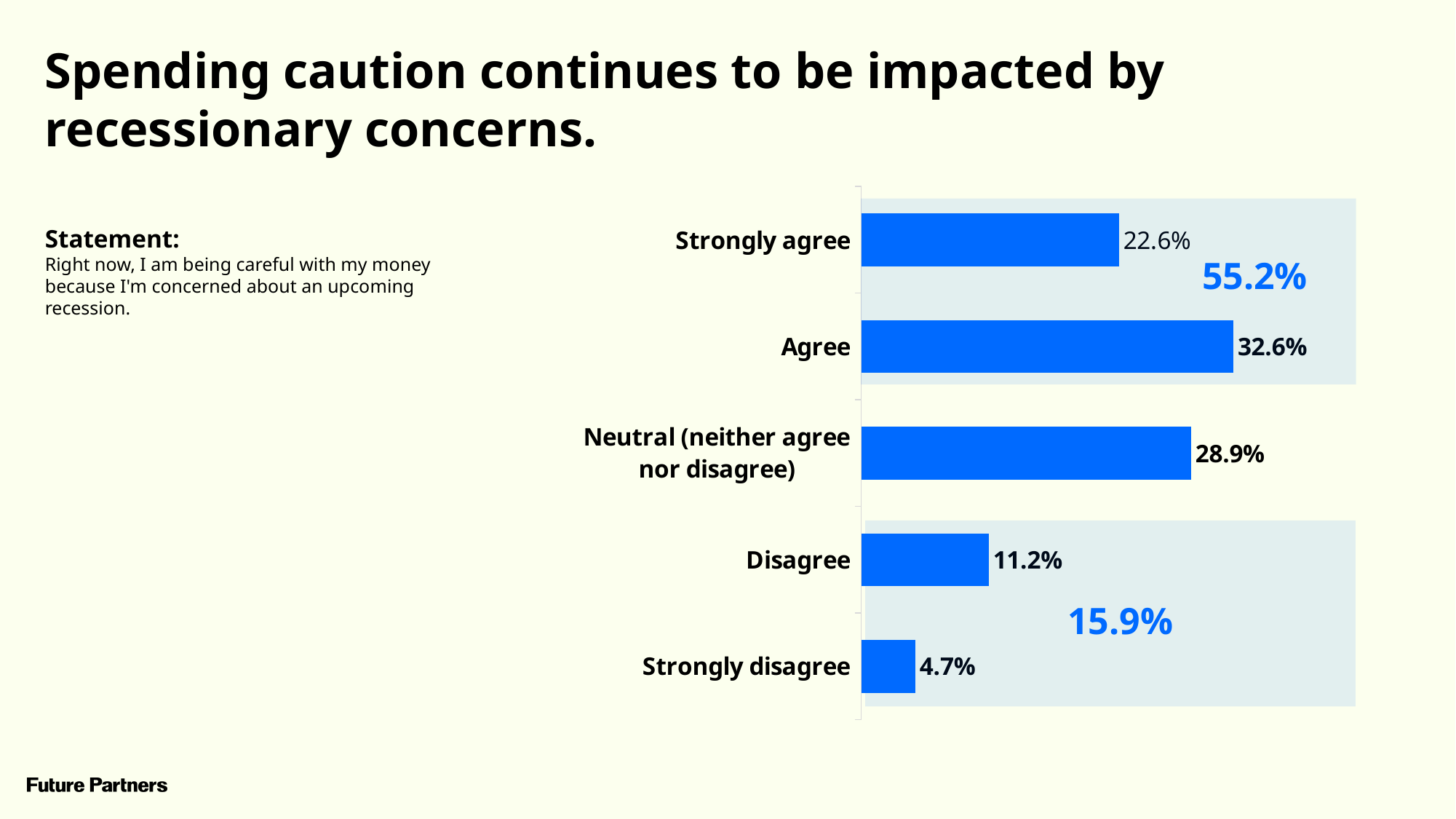
What combined percentage is shown for Strongly agree and Agree together? 55.2% Which is larger, the value for Neutral (neither agree nor disagree) or the value for Disagree? Neutral (neither agree nor disagree) What percentage of respondents agree with the statement? 32.6% What kind of chart is shown on the slide? Bar chart Which response category has the highest percentage? Agree What combined percentage is shown for Disagree and Strongly disagree together? 15.9% How many response categories are shown in the chart? 5 Which response category has the lowest percentage? Strongly disagree What percentage of respondents strongly disagree? 4.7% What is the value for Neutral (neither agree nor disagree)? 28.9% What percentage of respondents strongly agree with the statement? 22.6% What is the difference between the Agree and Strongly agree percentages? 10.0%